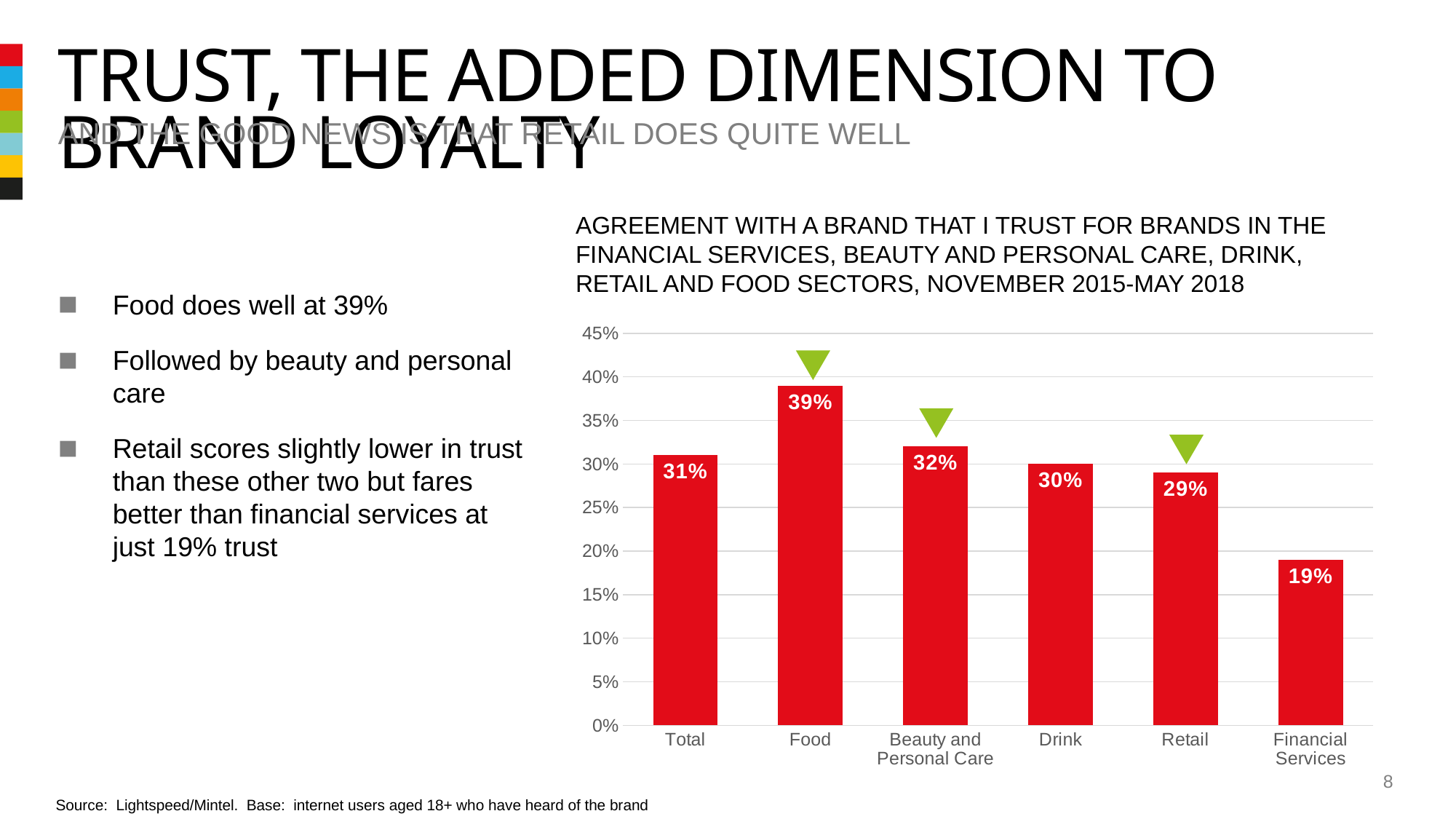
What kind of chart is shown on the slide? Bar chart What is the value for Total? 31% What is the value for Financial Services? 19% What is the value for Food? 39% What is the value for Retail? 29% How many categories are shown on the x axis? 6 Which category has the lowest value? Financial Services What is the difference between the values for Food and Financial Services? 20% What is the difference between the values for Beauty and Personal Care and Retail? 3% Which is larger, the value for Drink or the value for Financial Services? Drink What colour are the bars in the chart? Red Which category has the highest value? Food